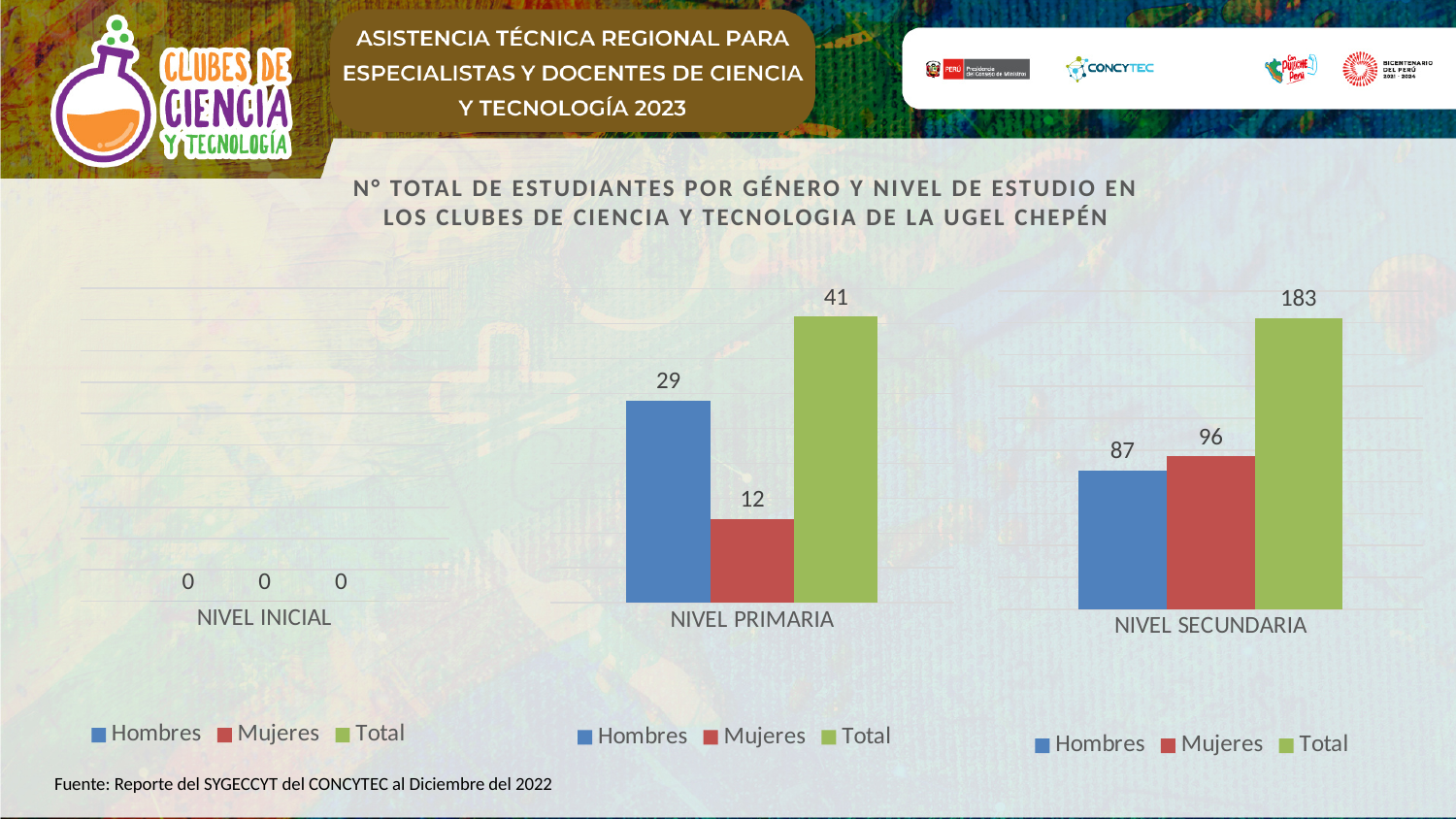
In the NIVEL SECUNDARIA chart, which is larger, Hombres or Mujeres? Mujeres In the NIVEL INICIAL chart, what is the value for Hombres? 0 In the NIVEL SECUNDARIA chart, what is the value for Mujeres? 96 In the NIVEL PRIMARIA chart, what is the difference between Hombres and Mujeres? 17 What kind of chart is the NIVEL SECUNDARIA chart? Bar chart In the NIVEL PRIMARIA chart, what is the value for Mujeres? 12 In the NIVEL PRIMARIA chart, what is the value for Hombres? 29 How many series does the legend of the NIVEL PRIMARIA chart list? 3 In the NIVEL PRIMARIA chart, which series has the highest value? Total In the NIVEL SECUNDARIA chart, which series has the lowest value? Hombres In the NIVEL SECUNDARIA chart, what is the difference between Mujeres and Hombres? 9 In the NIVEL SECUNDARIA chart, what is the value for Total? 183